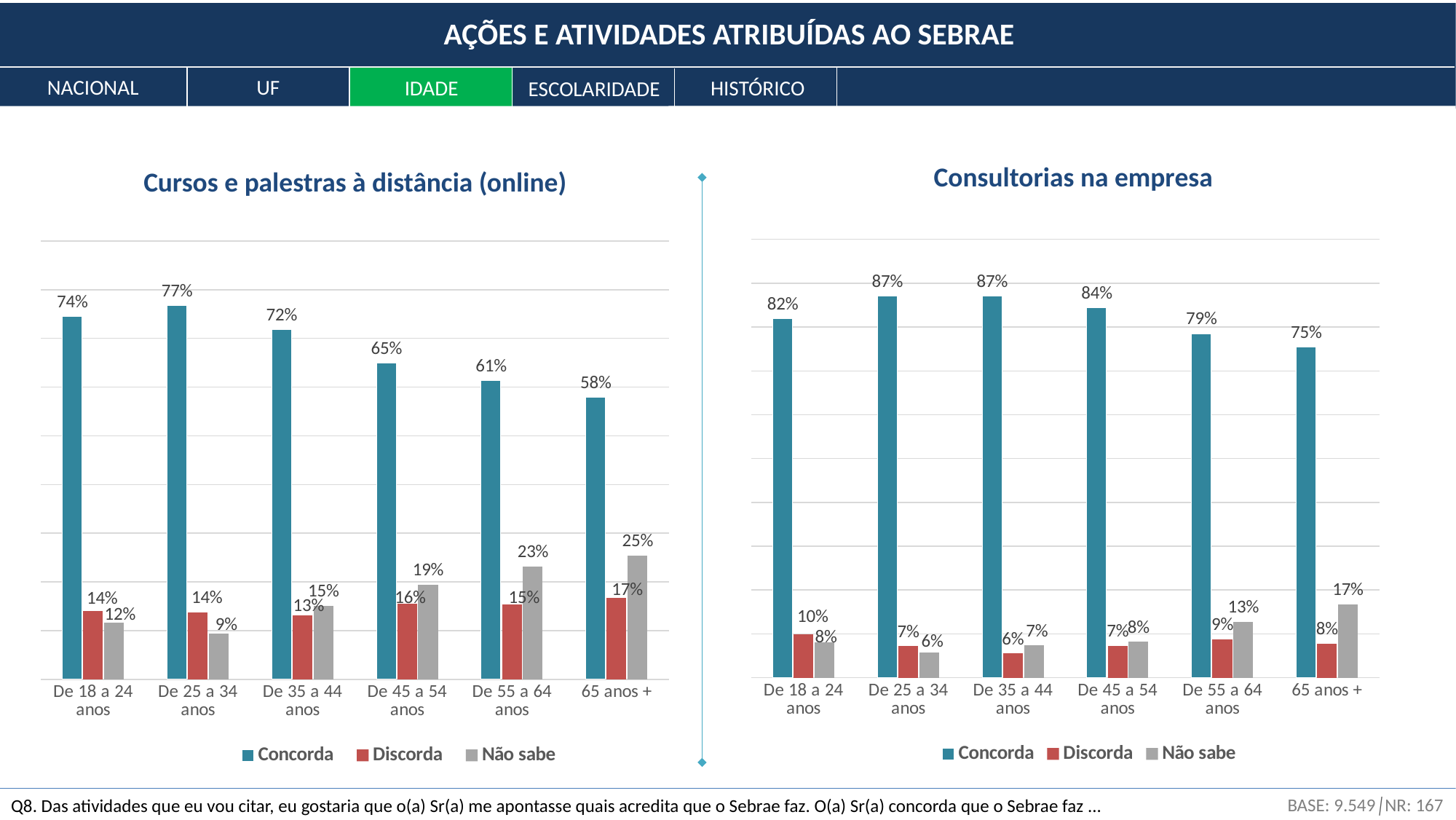
In the 'Consultorias na empresa' chart, what is the Não sabe value for '65 anos +'? 17% In the 'Consultorias na empresa' chart, what is the Discorda value for 'De 35 a 44 anos'? 6% In the 'Cursos e palestras à distância (online)' chart, what is the difference between the Concorda values for 'De 25 a 34 anos' and '65 anos +'? 19% In the 'Consultorias na empresa' chart, which age group has the lowest Concorda value? 65 anos + In the 'Cursos e palestras à distância (online)' chart, which age group has the highest Concorda value? De 25 a 34 anos In the 'Cursos e palestras à distância (online)' chart, do the Não sabe values rise or fall from 'De 35 a 44 anos' to '65 anos +'? rise How many series does the legend of the 'Consultorias na empresa' chart list? 3 In the 'Cursos e palestras à distância (online)' chart, what is the Concorda value for 'De 18 a 24 anos'? 74% How many age groups are shown on the x axis of the 'Cursos e palestras à distância (online)' chart? 6 What is the title of the chart on the left side of the slide? Cursos e palestras à distância (online) What kind of chart is the 'Consultorias na empresa' chart? bar chart In the 'Consultorias na empresa' chart, is the Concorda value for 'De 18 a 24 anos' larger or smaller than the Concorda value for 'De 55 a 64 anos'? larger